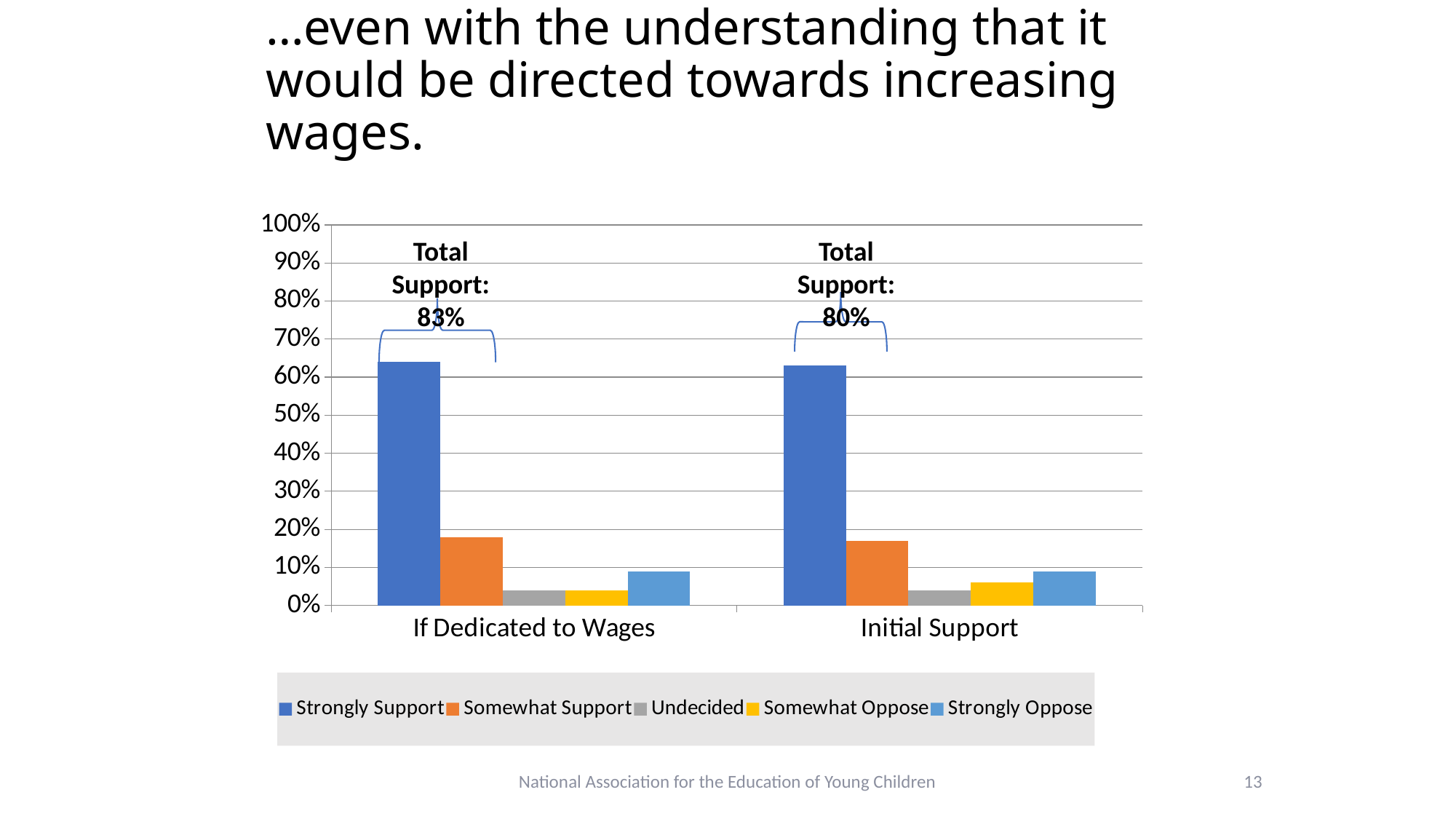
In the 'Initial Support' group, which is larger, Strongly Oppose or Undecided? Strongly Oppose How many categories are shown on the x axis of the chart? 2 Which legend entry is shown in yellow? Somewhat Oppose Is the value for Somewhat Support in the 'If Dedicated to Wages' group greater or less than 30%? less Which series has the highest value in the 'If Dedicated to Wages' group? Strongly Support How many series does the chart's legend list? 5 What kind of chart is shown on the slide? Bar chart What is the difference between the annotated total support for 'If Dedicated to Wages' and for 'Initial Support'? 3 percentage points Which category has the higher annotated total support, 'If Dedicated to Wages' or 'Initial Support'? If Dedicated to Wages What total support percentage is annotated above the 'If Dedicated to Wages' group? 83% Is the value for Strongly Support in the 'Initial Support' group greater or less than 50%? greater What total support percentage is annotated above the 'Initial Support' group? 80%